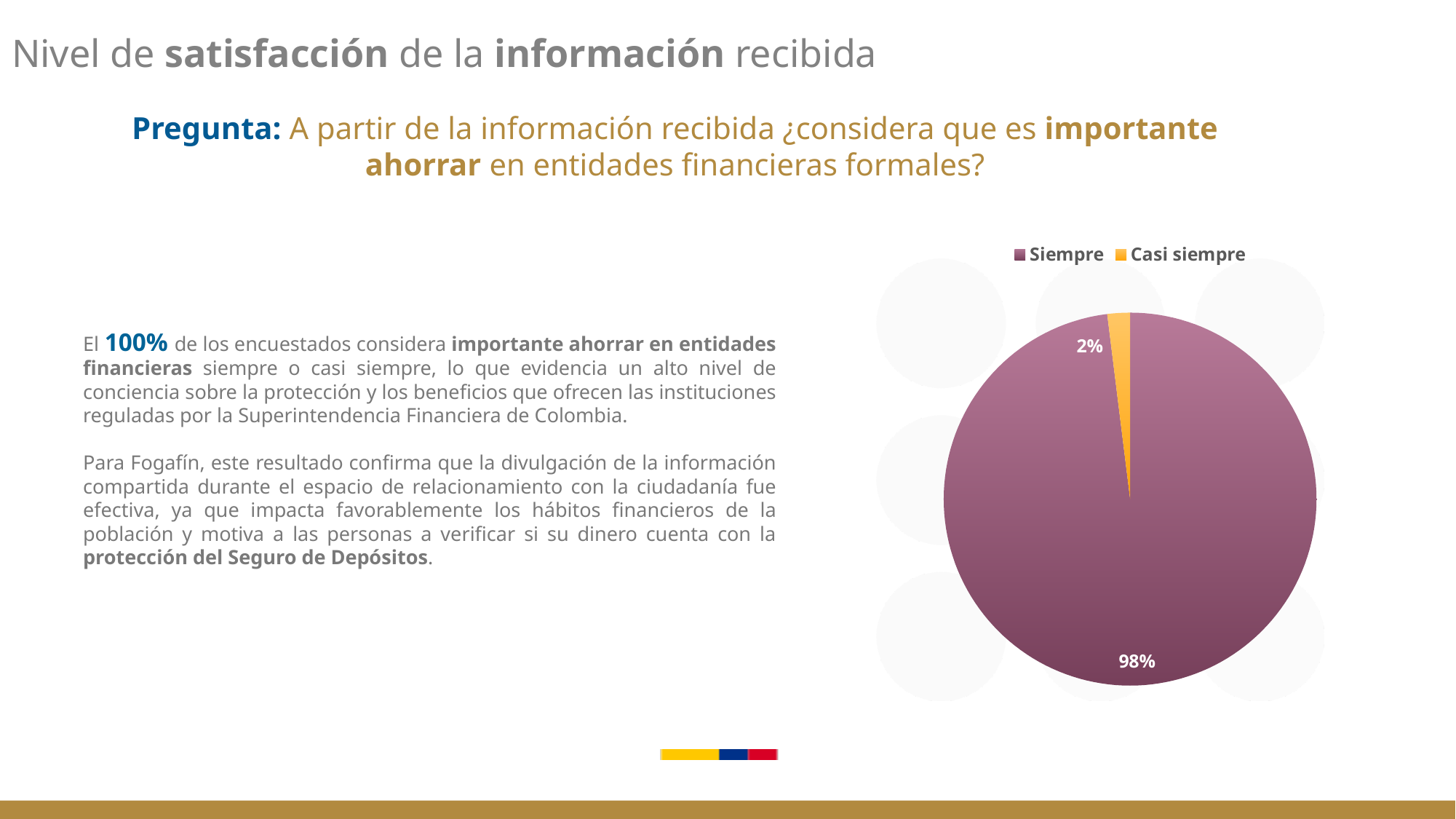
Which category has the smallest slice of the pie? Casi siempre What share of the pie does "Siempre" represent? 98% What colour is the "Siempre" slice? purple Which slice is larger, "Siempre" or "Casi siempre"? Siempre What share of the pie does "Casi siempre" represent? 2% What colour is the "Casi siempre" slice? orange What is the total of the two slices shown in the pie chart? 100% Which category has the largest slice of the pie? Siempre How many entries does the legend list? 2 How many categories does the pie chart show? 2 What kind of chart is shown on the slide? pie chart What is the difference in percentage points between the "Siempre" and "Casi siempre" slices? 96